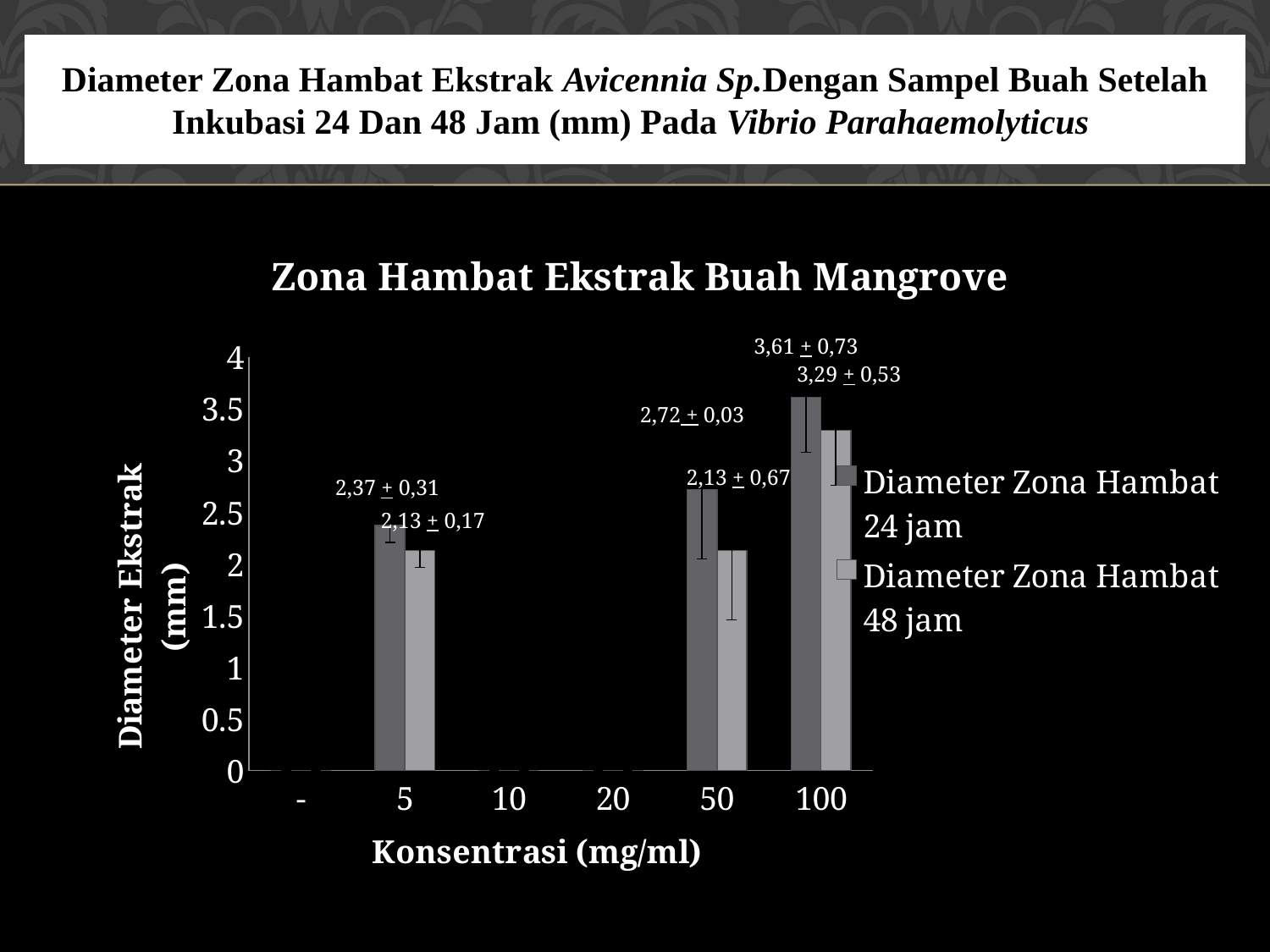
What is the difference between the mean Diameter Zona Hambat 24 jam and 48 jam at 100 mg/ml? 0,32 How many series does the legend list? 2 Is the value for Diameter Zona Hambat 48 jam at 50 mg/ml greater or less than 2.5? less At which concentration is the Diameter Zona Hambat 24 jam highest? 100 What type of chart is shown on the slide? bar chart At a concentration of 100 mg/ml, which is larger: Diameter Zona Hambat 24 jam or 48 jam? Diameter Zona Hambat 24 jam What is the title of the chart? Zona Hambat Ekstrak Buah Mangrove Does the Diameter Zona Hambat 24 jam rise or fall as concentration increases from 5 to 100 mg/ml? rise What is the labelled value for Diameter Zona Hambat 48 jam at a concentration of 5 mg/ml? 2,13 ± 0,17 What is the labelled value for Diameter Zona Hambat 24 jam at a concentration of 100 mg/ml? 3,61 ± 0,73 How many concentration categories are shown on the x axis? 6 What is the labelled value for Diameter Zona Hambat 24 jam at a concentration of 50 mg/ml? 2,72 ± 0,03